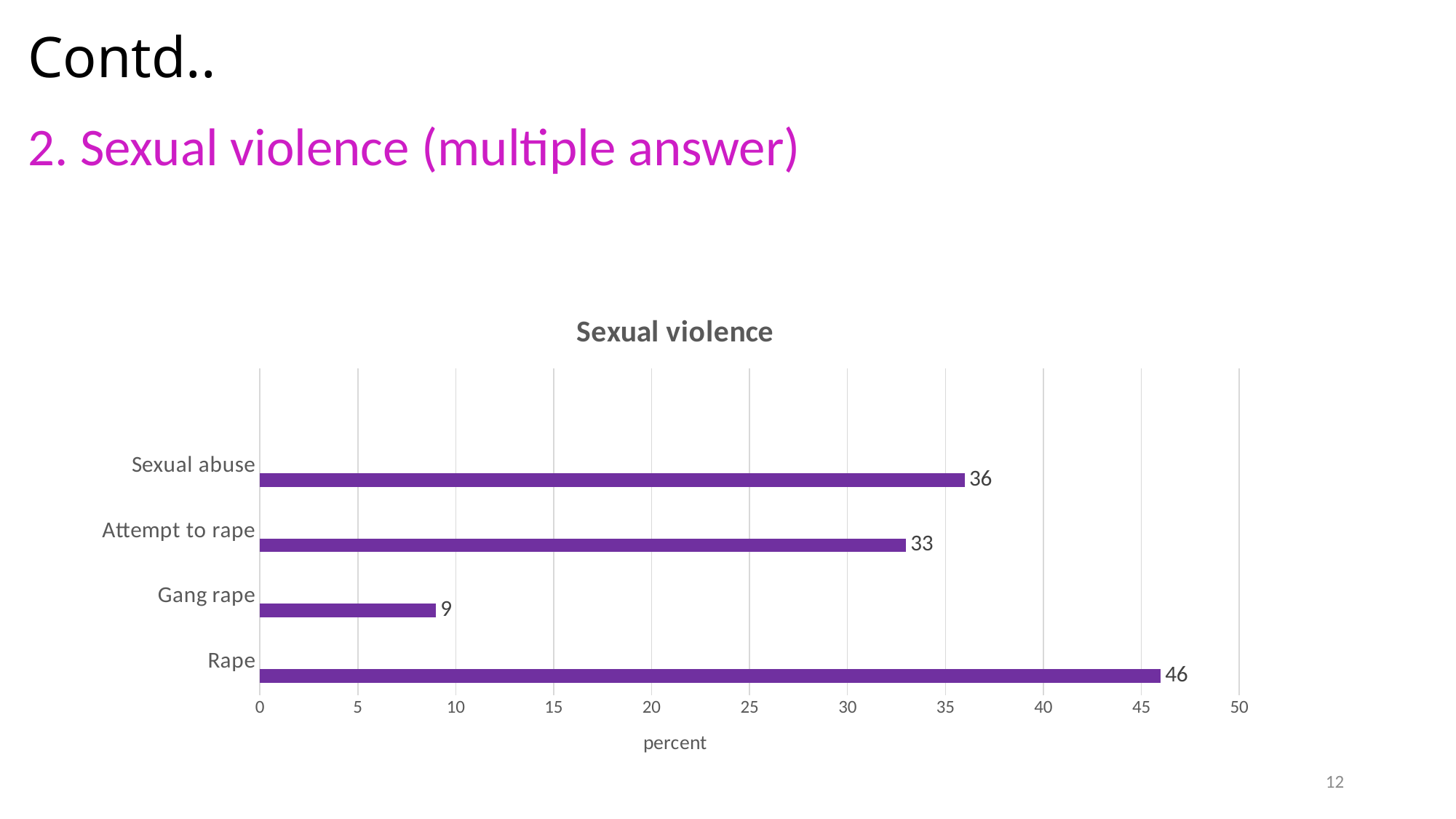
Which category has the lowest value? Gang rape What kind of chart is shown on the slide? bar chart What is the value for Sexual abuse? 36 How many categories are shown in the chart? 4 What is the difference between the values for Rape and Gang rape? 37 Which category has the highest value? Rape Which is larger, the value for Sexual abuse or the value for Attempt to rape? Sexual abuse What is the value for Gang rape? 9 What is the value for Attempt to rape? 33 What is the title of the chart? Sexual violence What is the value for Rape? 46 What is the difference between the values for Sexual abuse and Attempt to rape? 3